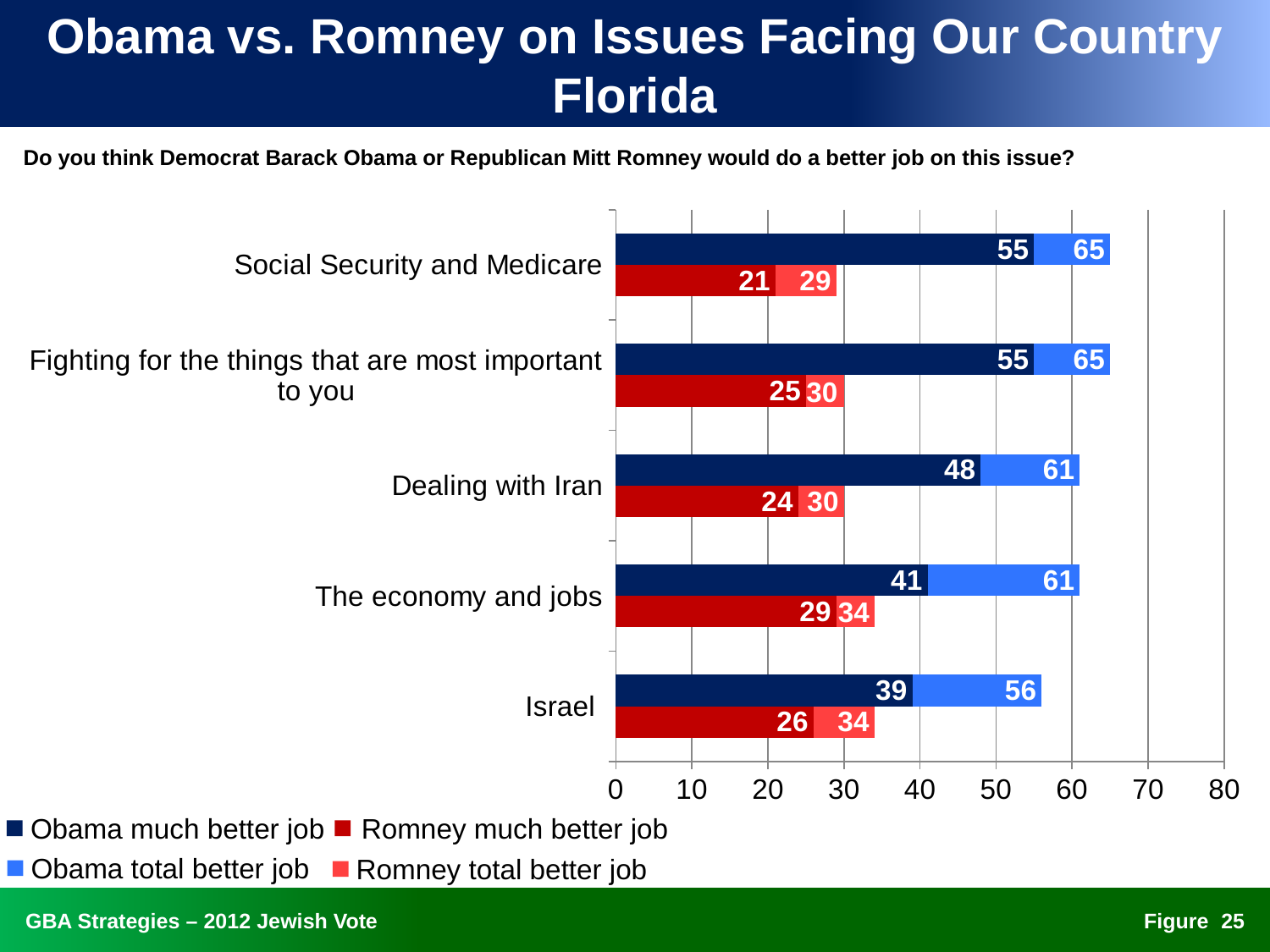
What is the value for "Obama much better job" on Israel? 39 How many issues are shown on the chart? 5 Which issue has the highest "Romney much better job" value? The economy and jobs What is the value for "Romney total better job" on The economy and jobs? 34 Which issue has the lowest "Obama total better job" value? Israel What is the maximum value shown on the horizontal axis? 80 What is the value for "Romney much better job" on Social Security and Medicare? 21 What is the value for "Obama total better job" on Dealing with Iran? 61 Which is larger on Dealing with Iran: "Obama much better job" or "Romney total better job"? Obama much better job What is the difference between "Obama total better job" and "Romney total better job" on Social Security and Medicare? 36 How many series does the legend list? 4 What kind of chart is shown on the slide? Bar chart